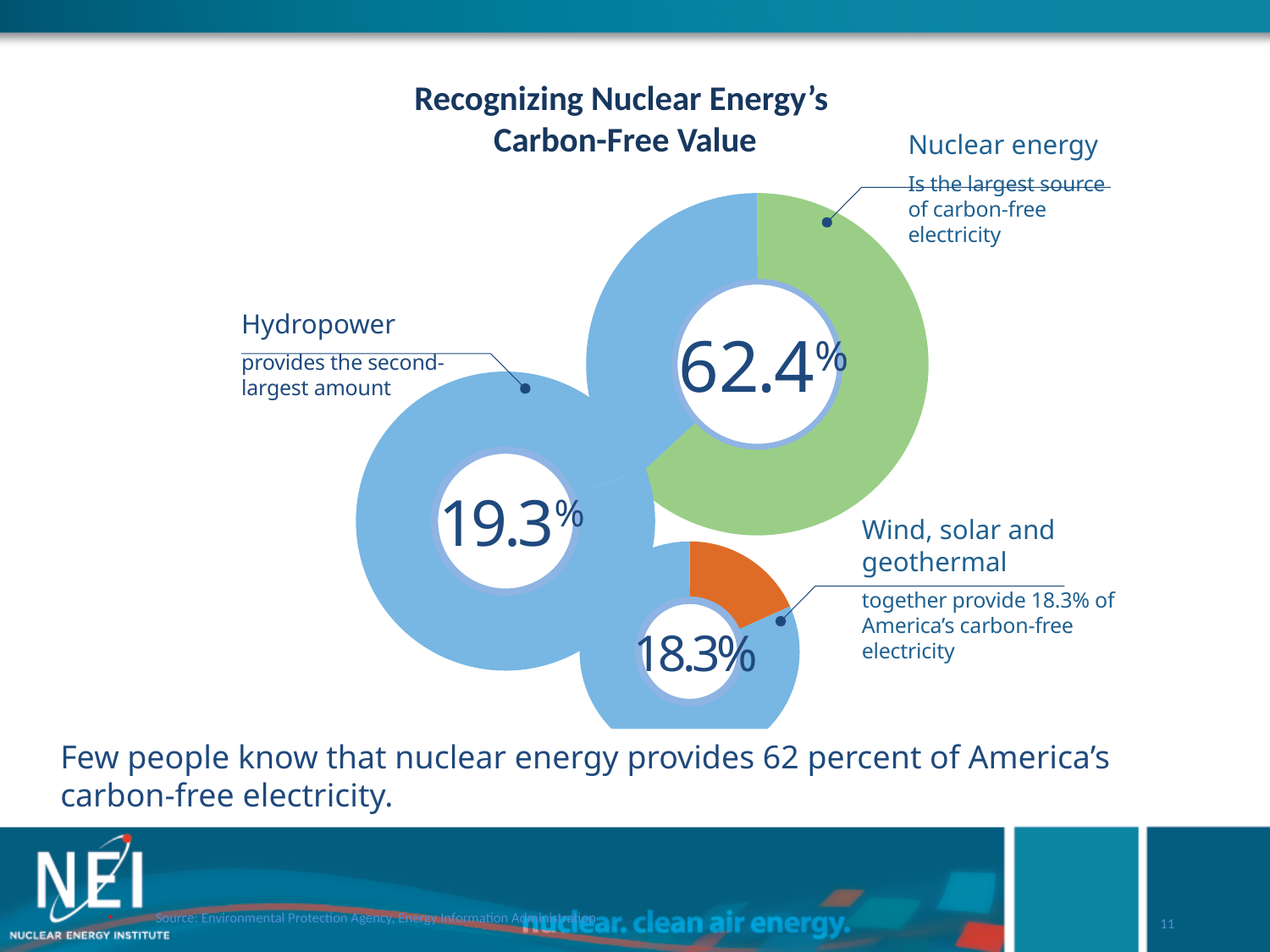
What is the difference in percentage points between the hydropower share and the wind, solar and geothermal share? 1.0 Is the value for nuclear energy greater or less than 50%? greater Which source has the smallest share of carbon-free electricity on the slide? Wind, solar and geothermal How many energy sources are shown with a percentage on the slide? 3 What is the difference in percentage points between the nuclear energy share and the hydropower share? 43.1 Which is larger, the share for hydropower or the share for wind, solar and geothermal? Hydropower What percentage of America's carbon-free electricity does nuclear energy provide, according to the chart? 62.4% What kind of chart is used to show the percentages on the slide? Donut (pie) chart What percentage is shown for hydropower? 19.3% What is the title of the chart on the slide? Recognizing Nuclear Energy's Carbon-Free Value Which source has the largest share of carbon-free electricity on the slide? Nuclear energy What percentage is shown for wind, solar and geothermal together? 18.3%